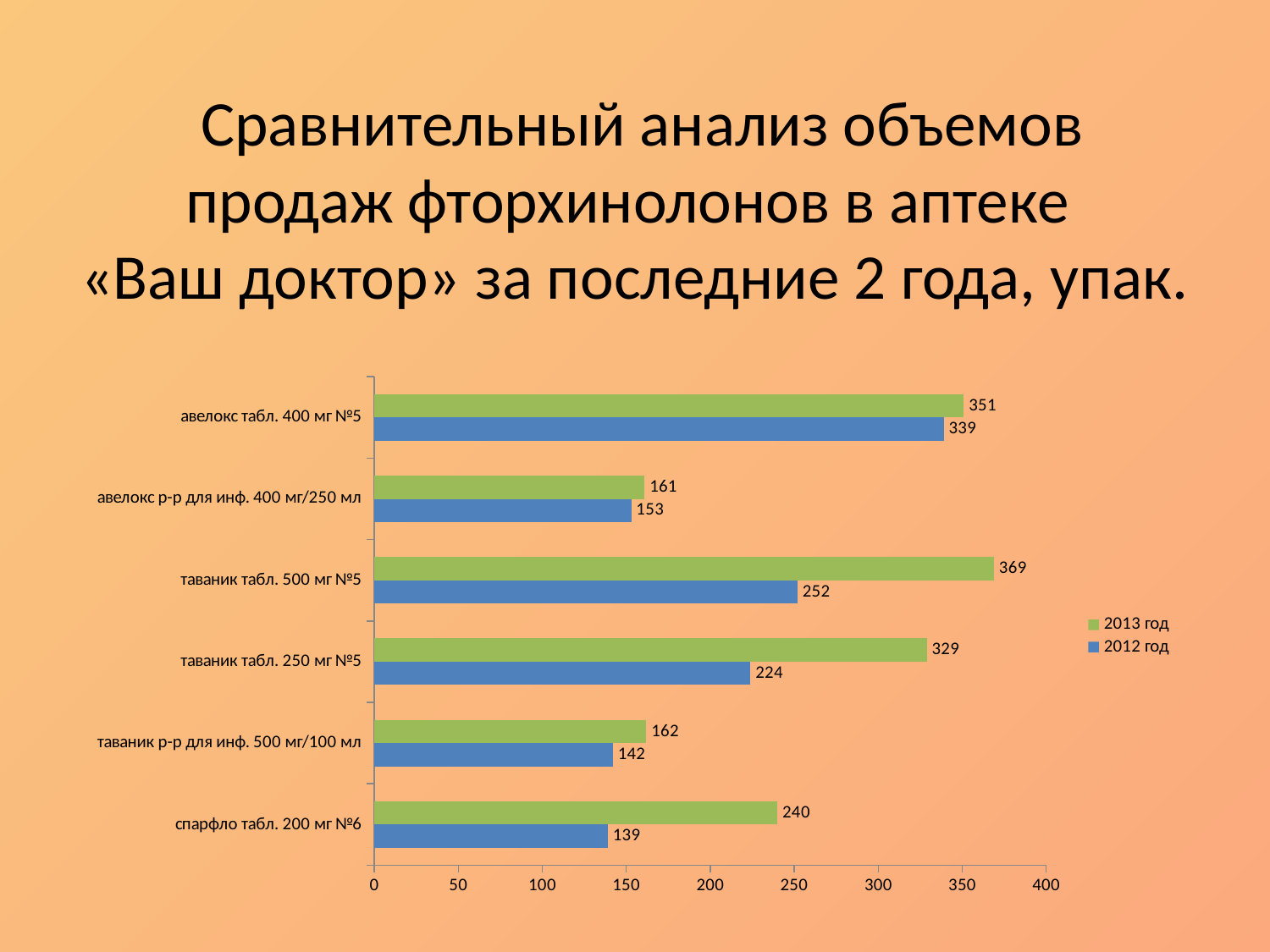
What kind of chart is shown on the slide? bar chart What is the difference between the 2013 год and 2012 год values for спарфло табл. 200 мг №6? 101 What was the 2013 год value for таваник табл. 500 мг №5? 369 Is the 2013 год value for авелокс р-р для инф. 400 мг/250 мл greater or less than 200? less What was the 2012 год value for спарфло табл. 200 мг №6? 139 How many series does the legend list? 2 Which category has the highest 2013 год value? таваник табл. 500 мг №5 What is the difference between the 2013 год and 2012 год values for таваник табл. 500 мг №5? 117 What was the 2012 год value for авелокс табл. 400 мг №5? 339 Which is larger: the 2012 год value for таваник табл. 250 мг №5 or the 2012 год value for таваник табл. 500 мг №5? таваник табл. 500 мг №5 Which category has the lowest 2012 год value? спарфло табл. 200 мг №6 How many product categories are shown on the chart? 6